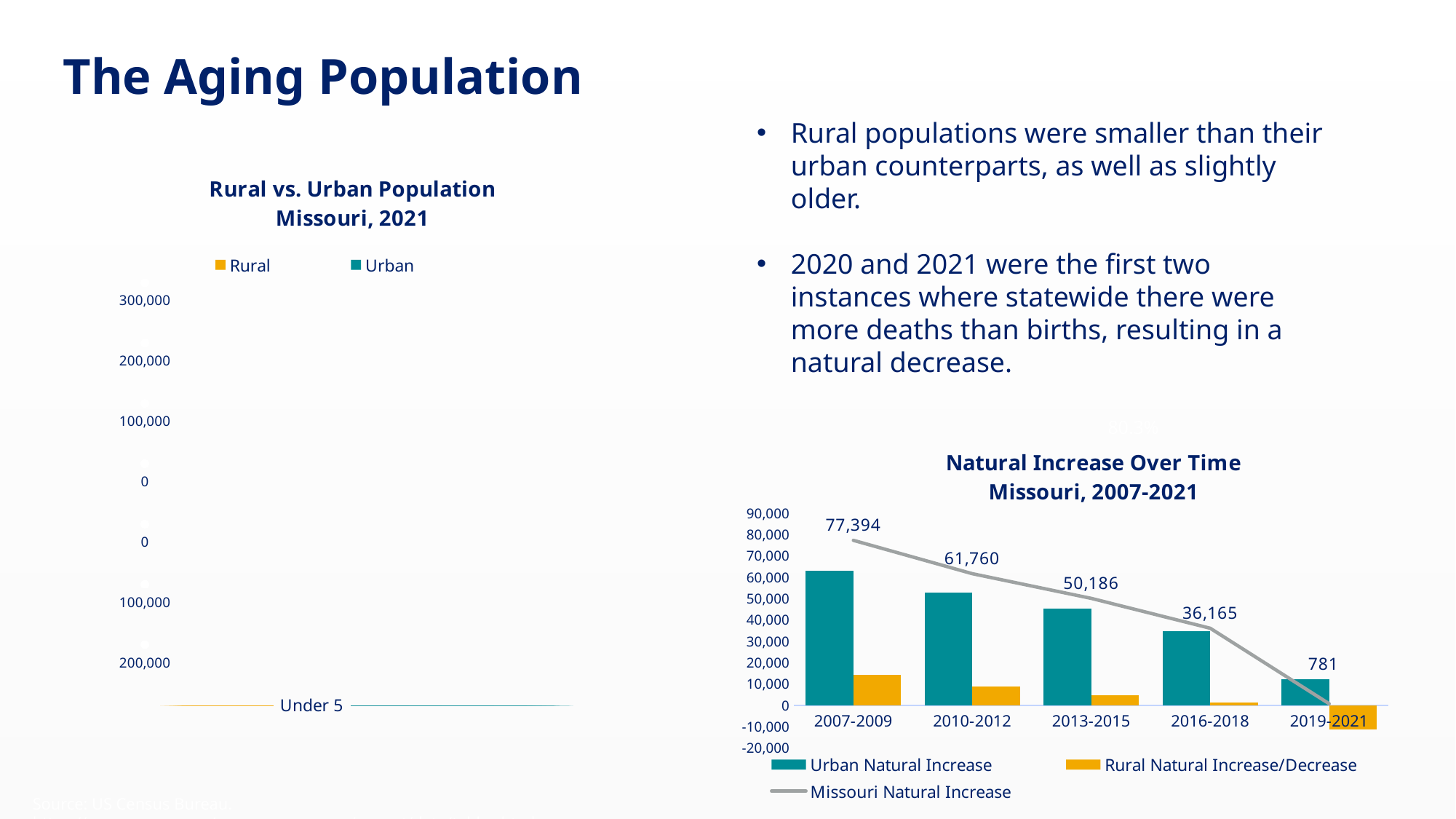
In the Natural Increase Over Time chart, what is the difference between the Missouri Natural Increase for 2007-2009 and 2010-2012? 15,634 In the Natural Increase Over Time chart, which period has the highest Missouri Natural Increase? 2007-2009 In the Natural Increase Over Time chart, what is the Missouri Natural Increase value for 2007-2009? 77,394 In the Natural Increase Over Time chart, is the Rural Natural Increase/Decrease for 2019-2021 greater or less than 0? less In the Natural Increase Over Time chart, how many series does the legend list? 3 In the Natural Increase Over Time chart, which period has the lowest Missouri Natural Increase? 2019-2021 What two series does the legend of the Rural vs. Urban Population chart on the left list? Rural and Urban In the Natural Increase Over Time chart, how many time periods are shown on the x axis? 5 In the Natural Increase Over Time chart, what is the Missouri Natural Increase value for 2019-2021? 781 In the Natural Increase Over Time chart, does the Missouri Natural Increase rise or fall from 2007-2009 to 2019-2021? fall In the Natural Increase Over Time chart, what is the Missouri Natural Increase value for 2013-2015? 50,186 In the Natural Increase Over Time chart, is the Urban Natural Increase for 2007-2009 greater or less than 50,000? greater